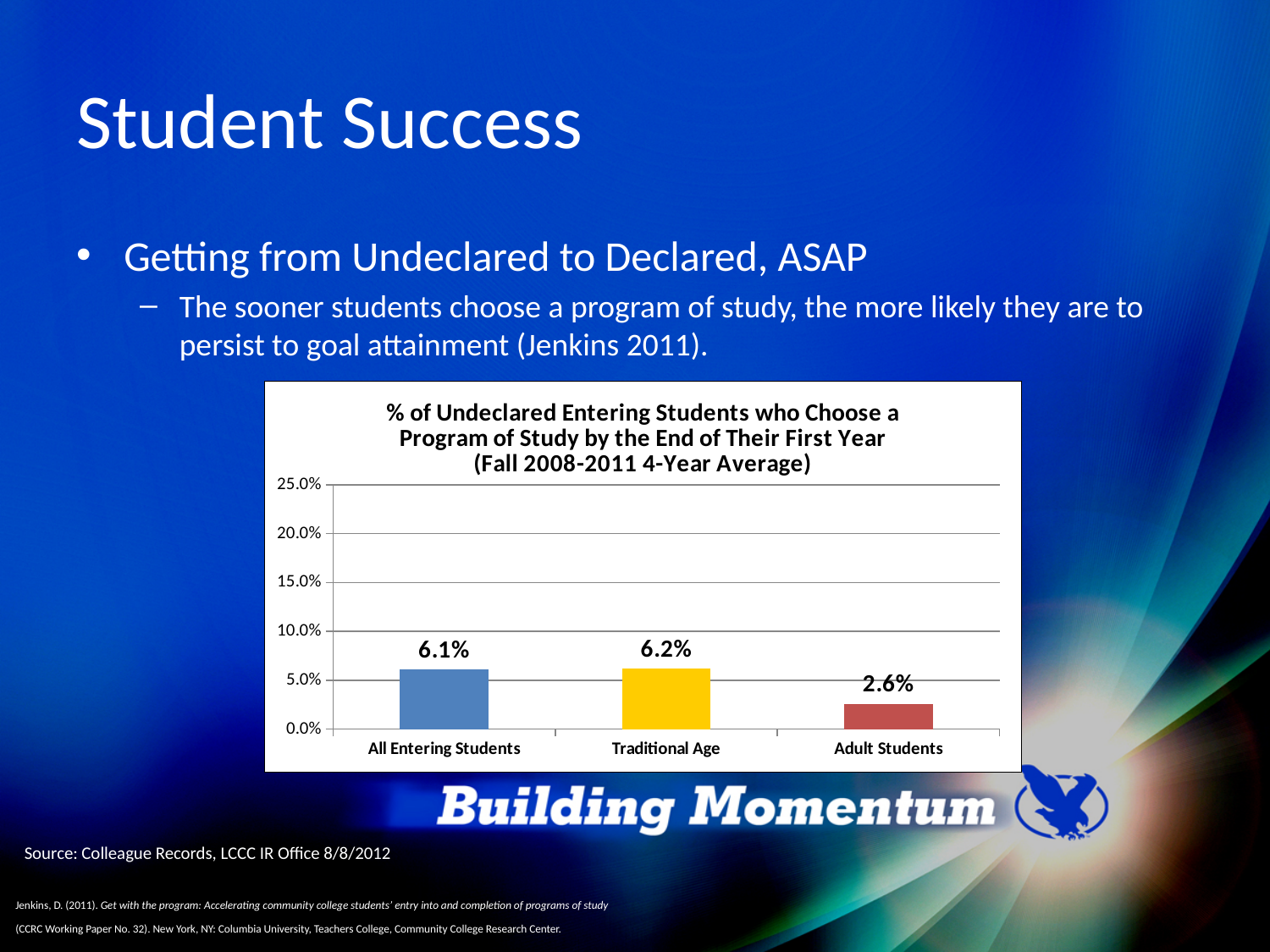
How many categories are shown on the x axis? 3 What is the value for Traditional Age? 6.2% What is the difference between the values for Traditional Age and Adult Students? 3.6% What is the difference between the values for All Entering Students and Adult Students? 3.5% What kind of chart is shown on the slide? bar chart Which is larger, the value for Traditional Age or the value for Adult Students? Traditional Age Which category has the lowest value? Adult Students What is the value for All Entering Students? 6.1% Is the value for Adult Students greater or less than 5.0%? less What is the highest value shown on the y axis? 25.0% Is the value for Traditional Age greater or less than 10.0%? less What is the value for Adult Students? 2.6%